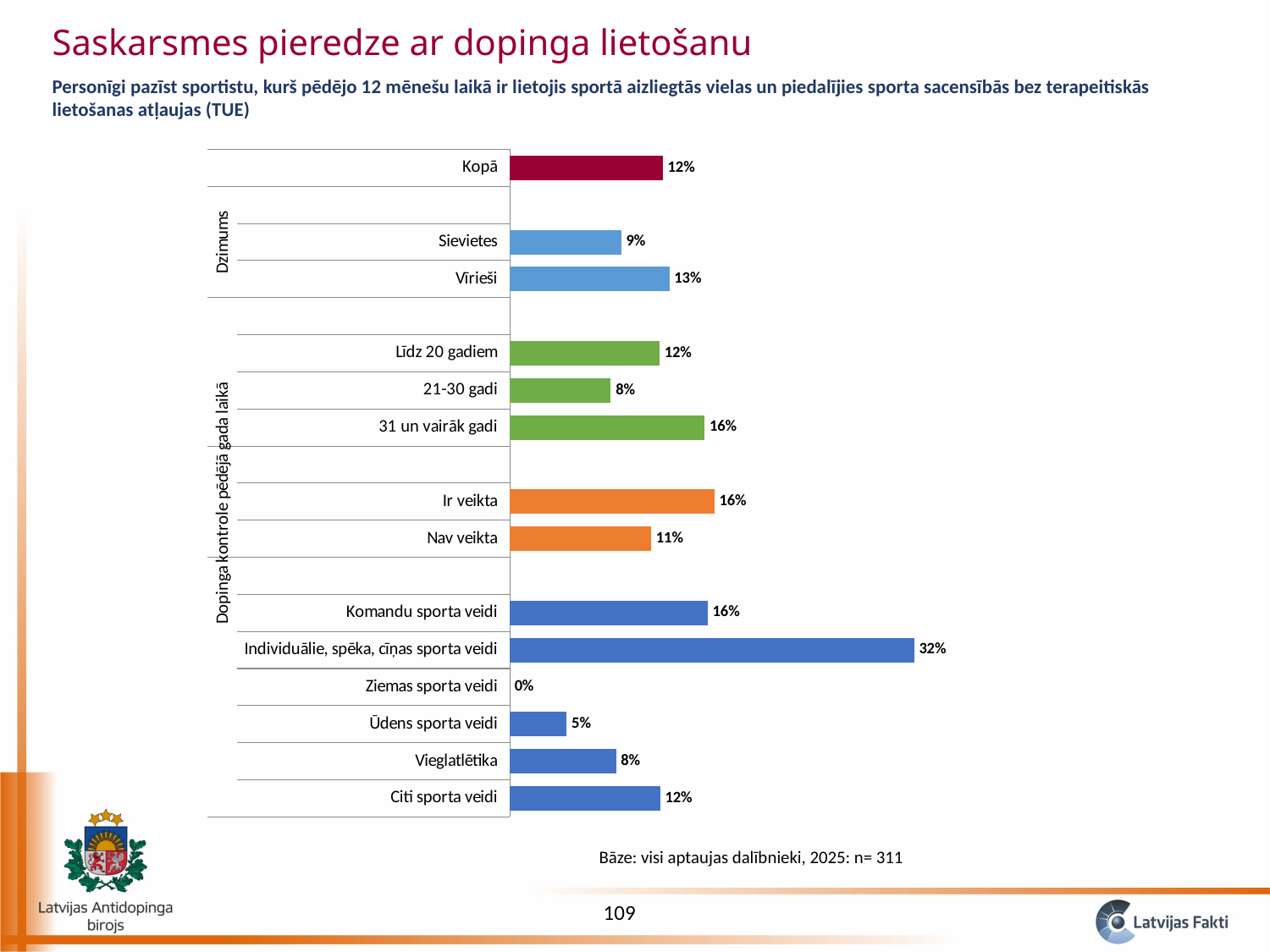
Which category has the lowest value? Ziemas sporta veidi Which is larger, the value for 31 un vairāk gadi or the value for 21-30 gadi? 31 un vairāk gadi Which category has the highest value? Individuālie, spēka, cīņas sporta veidi What is the value for Kopā? 12% What is the difference between the values for Ir veikta and Nav veikta? 5% What is the base (n) stated below the chart? n= 311 What kind of chart is shown on the slide? Bar chart What is the value for Individuālie, spēka, cīņas sporta veidi? 32% How many categories are shown in the chart? 14 What is the value for Ūdens sporta veidi? 5% What is the difference between the values for Vīrieši and Sievietes? 4% What is the value for Sievietes? 9%